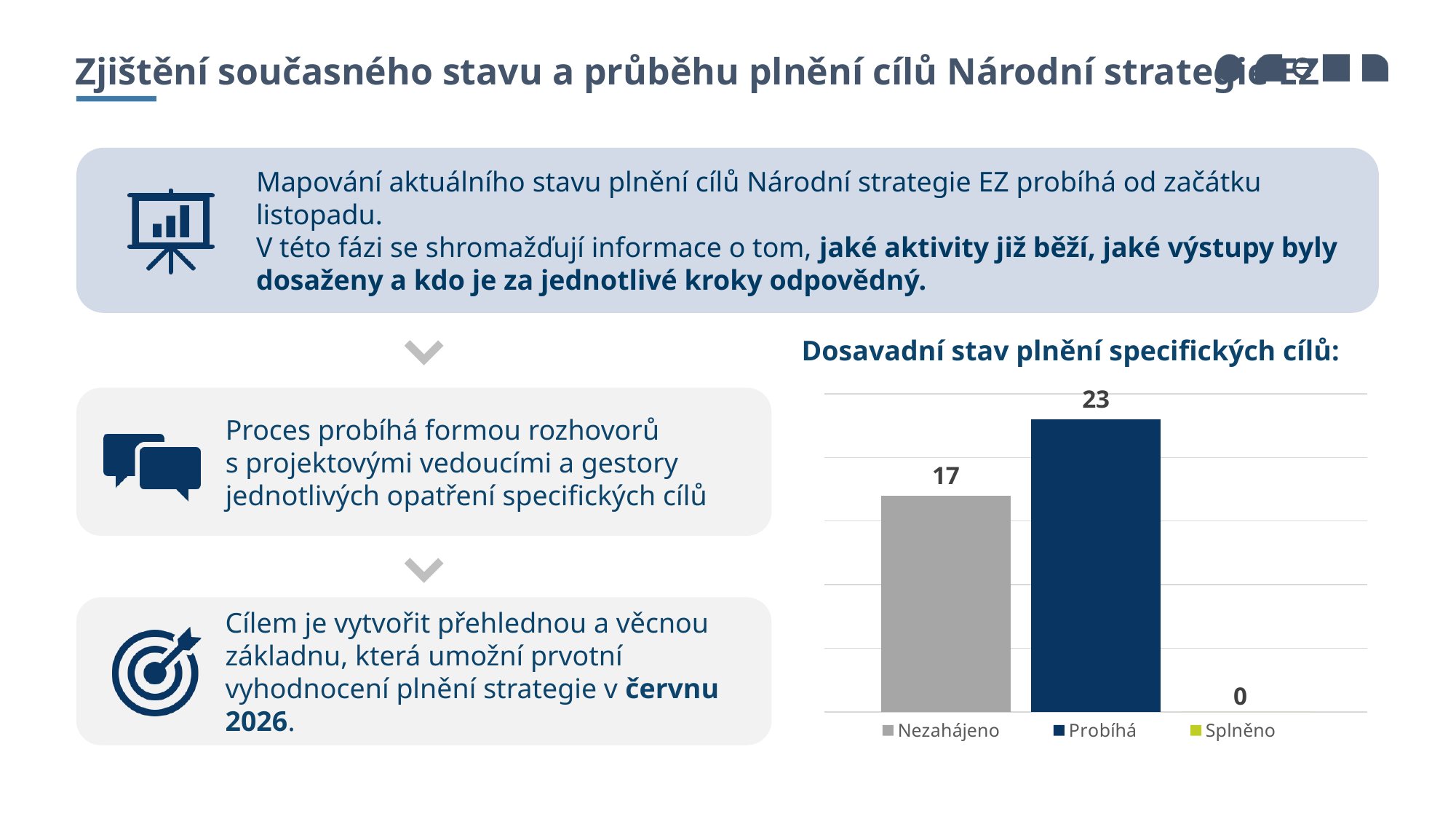
Which category has the highest value in the chart? Probíhá Which is larger, the value for Nezahájeno or the value for Probíhá? Probíhá How many categories are shown in the chart? 3 What is the value for Nezahájeno in the chart? 17 What is the value for Splněno in the chart? 0 What is the difference between the values for Probíhá and Nezahájeno? 6 What is the total of the three values shown in the chart? 40 What kind of chart is shown on the slide? Bar chart Which category has the lowest value in the chart? Splněno What is the title of the chart? Dosavadní stav plnění specifických cílů: What is the value for Probíhá in the chart? 23 How many entries does the chart legend list? 3